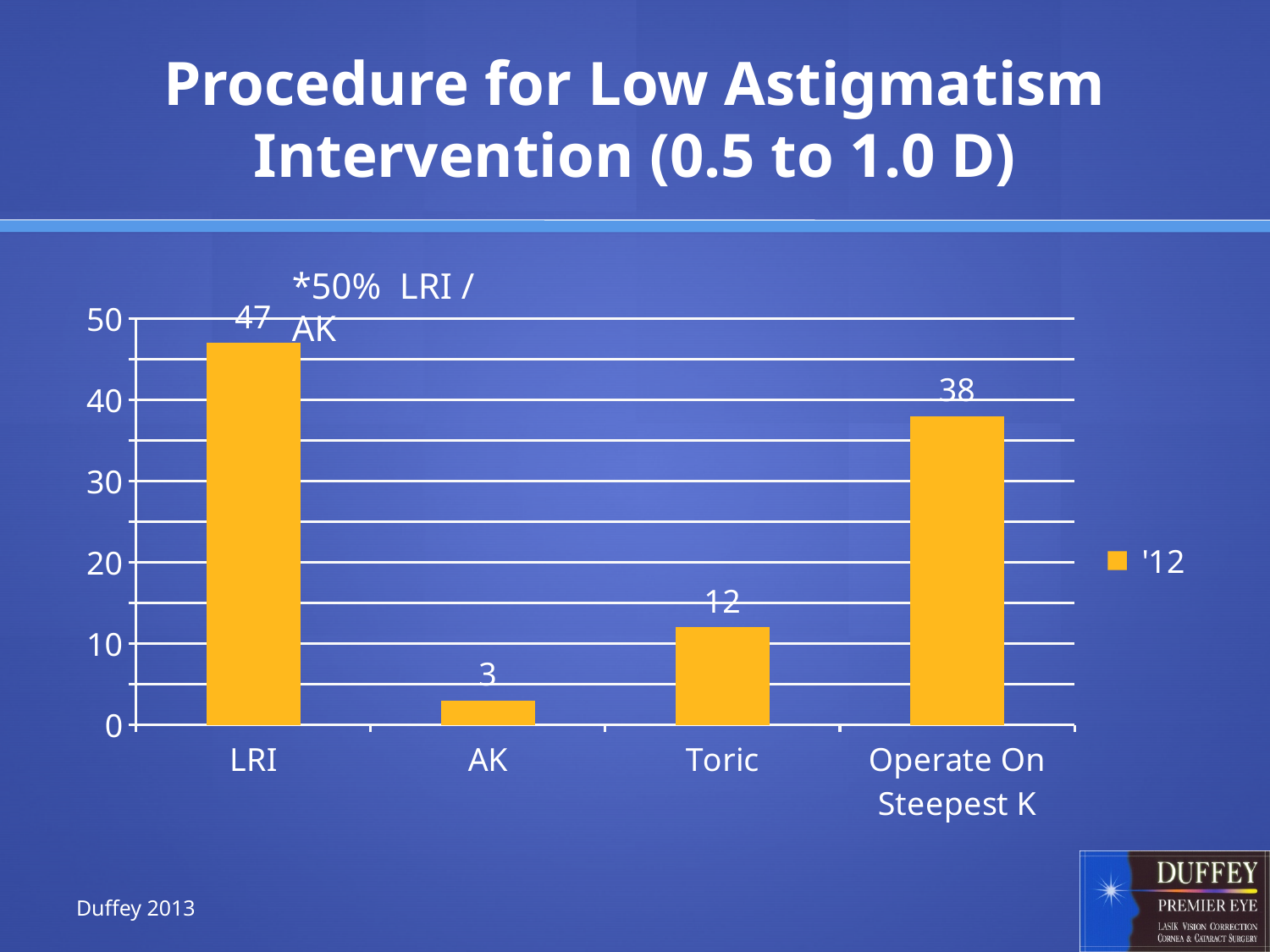
What kind of chart is shown on the slide? bar chart What is the value for LRI? 47 Is the value for Operate On Steepest K greater or less than 30? greater What is the difference between the values for LRI and Operate On Steepest K? 9 Which category has the highest value? LRI How many categories are shown on the x axis? 4 Which category has the lowest value? AK What is the value for Toric? 12 Which is larger, the value for Toric or the value for AK? Toric What is the value for AK? 3 What series name does the legend list? '12 What is the value for Operate On Steepest K? 38